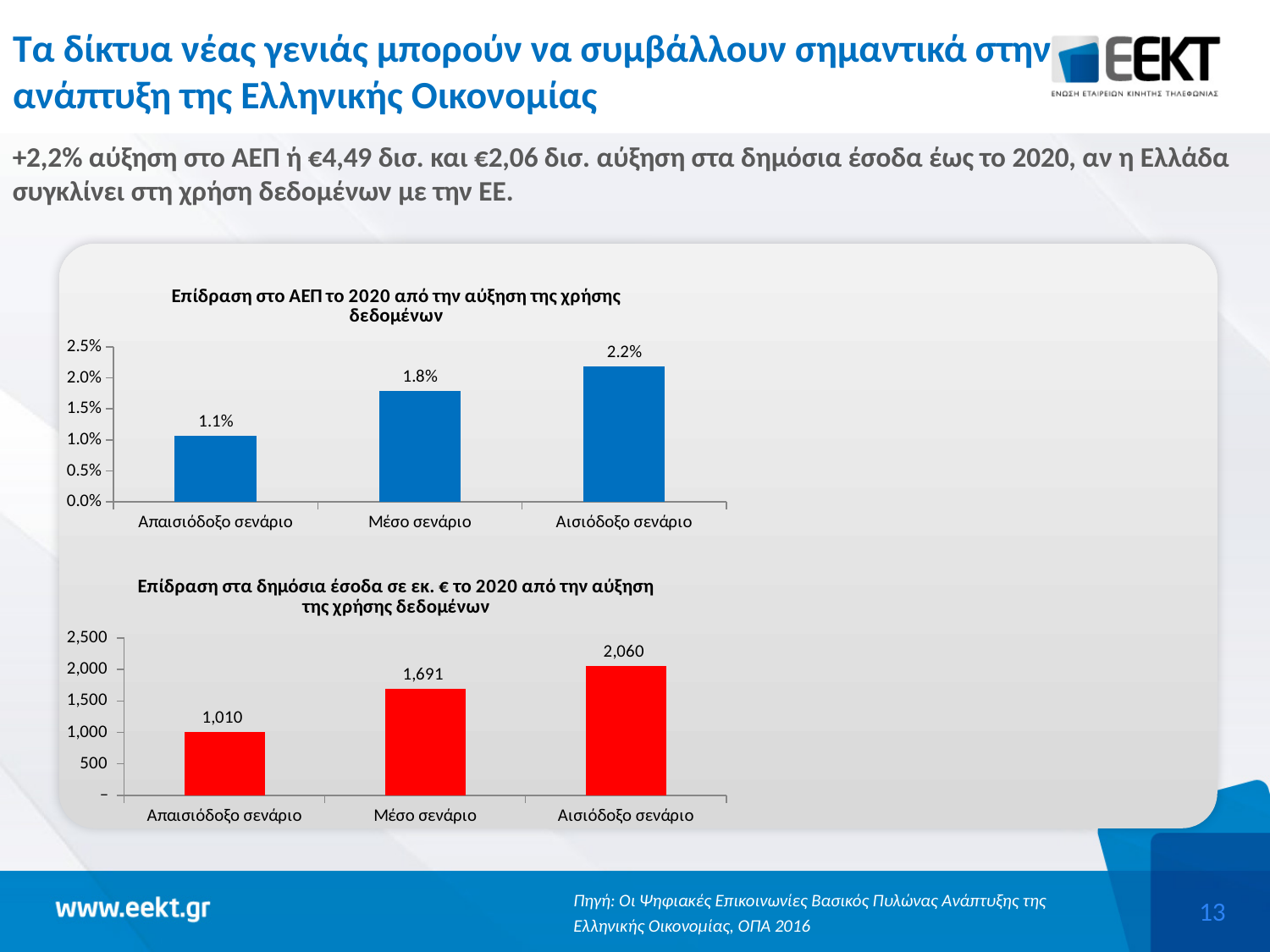
In the top chart (Επίδραση στο ΑΕΠ το 2020), which scenario has the lowest value? Απαισιόδοξο σενάριο What kind of chart is the bottom chart (Επίδραση στα δημόσια έσοδα)? bar chart In the top chart (Επίδραση στο ΑΕΠ το 2020), how many scenarios are shown? 3 In the bottom chart (Επίδραση στα δημόσια έσοδα), what is the value for Αισιόδοξο σενάριο? 2,060 In the top chart (Επίδραση στο ΑΕΠ το 2020), which scenario has the highest value? Αισιόδοξο σενάριο In the bottom chart (Επίδραση στα δημόσια έσοδα), is the value for Μέσο σενάριο larger or smaller than the value for Αισιόδοξο σενάριο? smaller In the top chart (Επίδραση στο ΑΕΠ το 2020), what is the difference between Αισιόδοξο σενάριο and Απαισιόδοξο σενάριο? 1.1% In the bottom chart (Επίδραση στα δημόσια έσοδα), what is the difference between Μέσο σενάριο and Απαισιόδοξο σενάριο? 681 In the top chart (Επίδραση στο ΑΕΠ το 2020), what is the value for Μέσο σενάριο? 1.8% In the bottom chart (Επίδραση στα δημόσια έσοδα), do the values rise or fall from Απαισιόδοξο σενάριο to Αισιόδοξο σενάριο? rise In the bottom chart (Επίδραση στα δημόσια έσοδα), what is the value for Απαισιόδοξο σενάριο? 1,010 What colour are the bars in the top chart (Επίδραση στο ΑΕΠ το 2020)? blue